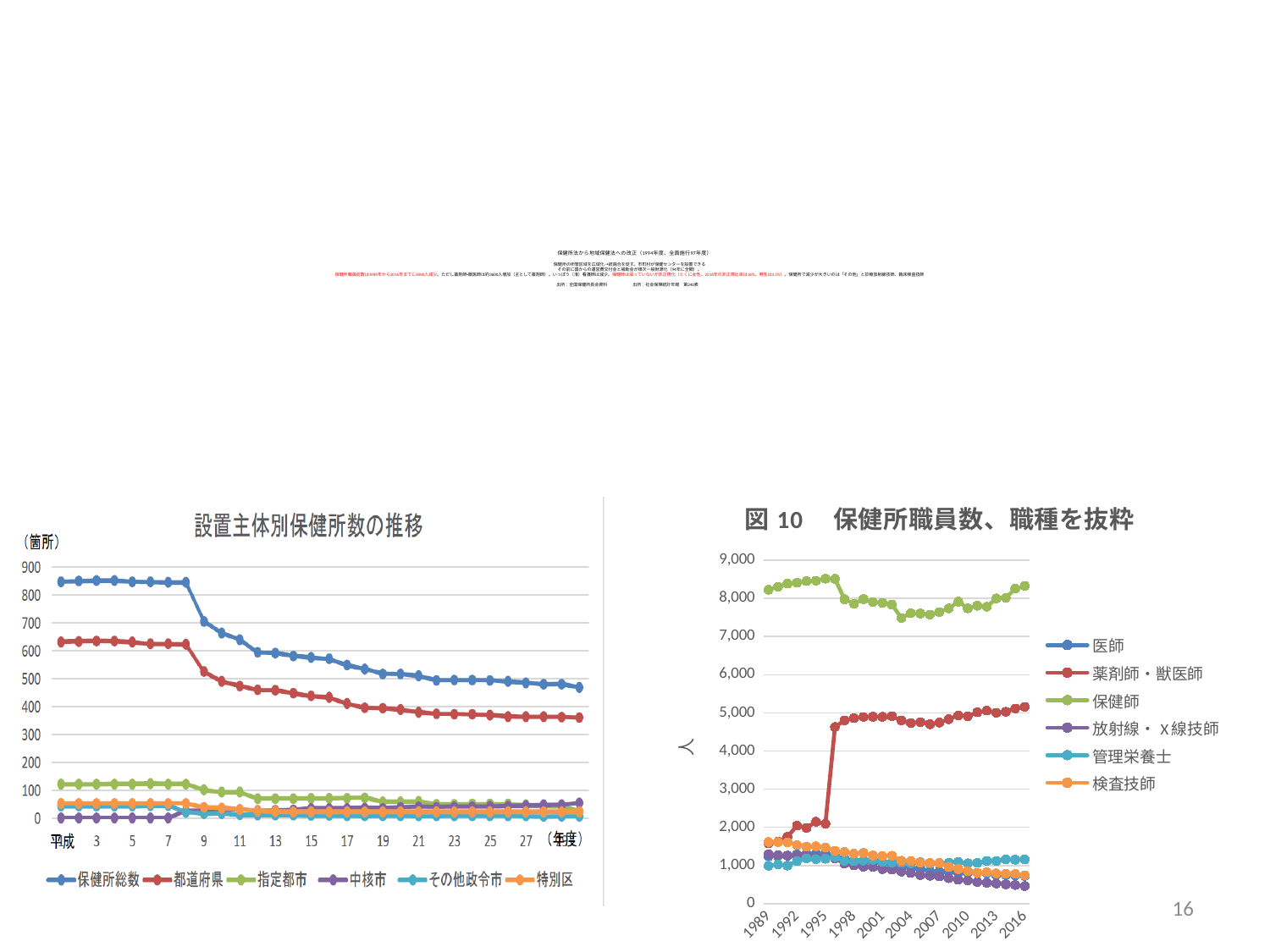
On the left chart titled 設置主体別保健所数の推移, is the value for 保健所総数 in the first year (平成) greater or less than 800? greater On the left chart titled 設置主体別保健所数の推移, which is larger in year 9, 保健所総数 or 都道府県? 保健所総数 On the left chart titled 設置主体別保健所数の推移, what unit is shown at the top of the vertical axis? 箇所 On the right chart titled 図 10 保健所職員数、職種を抜粋, which series has the highest values throughout? 保健師 On the right chart titled 図 10 保健所職員数、職種を抜粋, does the 薬剤師・獣医師 series rise or fall from 1989 to 2016? rise On the left chart titled 設置主体別保健所数の推移, what kind of chart is it? line chart On the right chart titled 図 10 保健所職員数、職種を抜粋, what kind of chart is it? line chart On the left chart titled 設置主体別保健所数の推移, how many series does the legend list? 6 On the left chart titled 設置主体別保健所数の推移, does the 保健所総数 series rise or fall over the years shown? fall On the left chart titled 設置主体別保健所数の推移, is the value for 都道府県 in year 27 greater or less than 400? less On the right chart titled 図 10 保健所職員数、職種を抜粋, is the value for 保健師 in 1989 greater or less than 8,000? greater On the right chart titled 図 10 保健所職員数、職種を抜粋, how many series does the legend list? 6